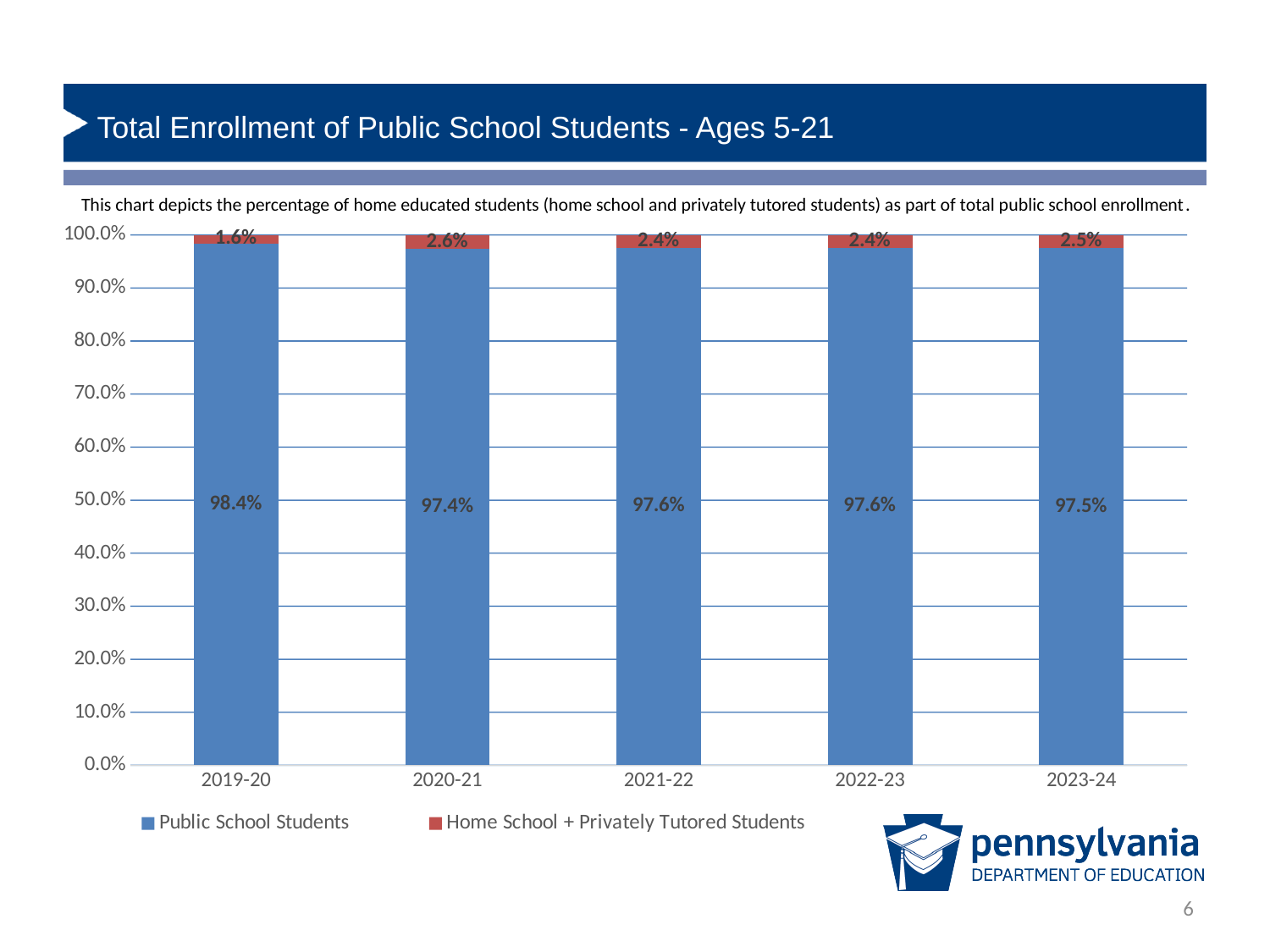
What percentage of enrollment was Public School Students in 2019-20? 98.4% What percentage of enrollment was Home School + Privately Tutored Students in 2020-21? 2.6% How many series does the legend list? 2 In which year was the Home School + Privately Tutored Students share lowest? 2019-20 What is the difference between the Home School + Privately Tutored Students share in 2020-21 and in 2019-20? 1.0% How many school years are shown on the x axis? 5 Which colour represents Home School + Privately Tutored Students in the chart? Red What percentage of enrollment was Public School Students in 2023-24? 97.5% What is the total of the stacked bar for 2021-22? 100.0% Which is larger, the Public School Students share in 2019-20 or in 2020-21? 2019-20 In which year was the Home School + Privately Tutored Students share highest? 2020-21 What kind of chart is shown on the slide? Stacked bar chart